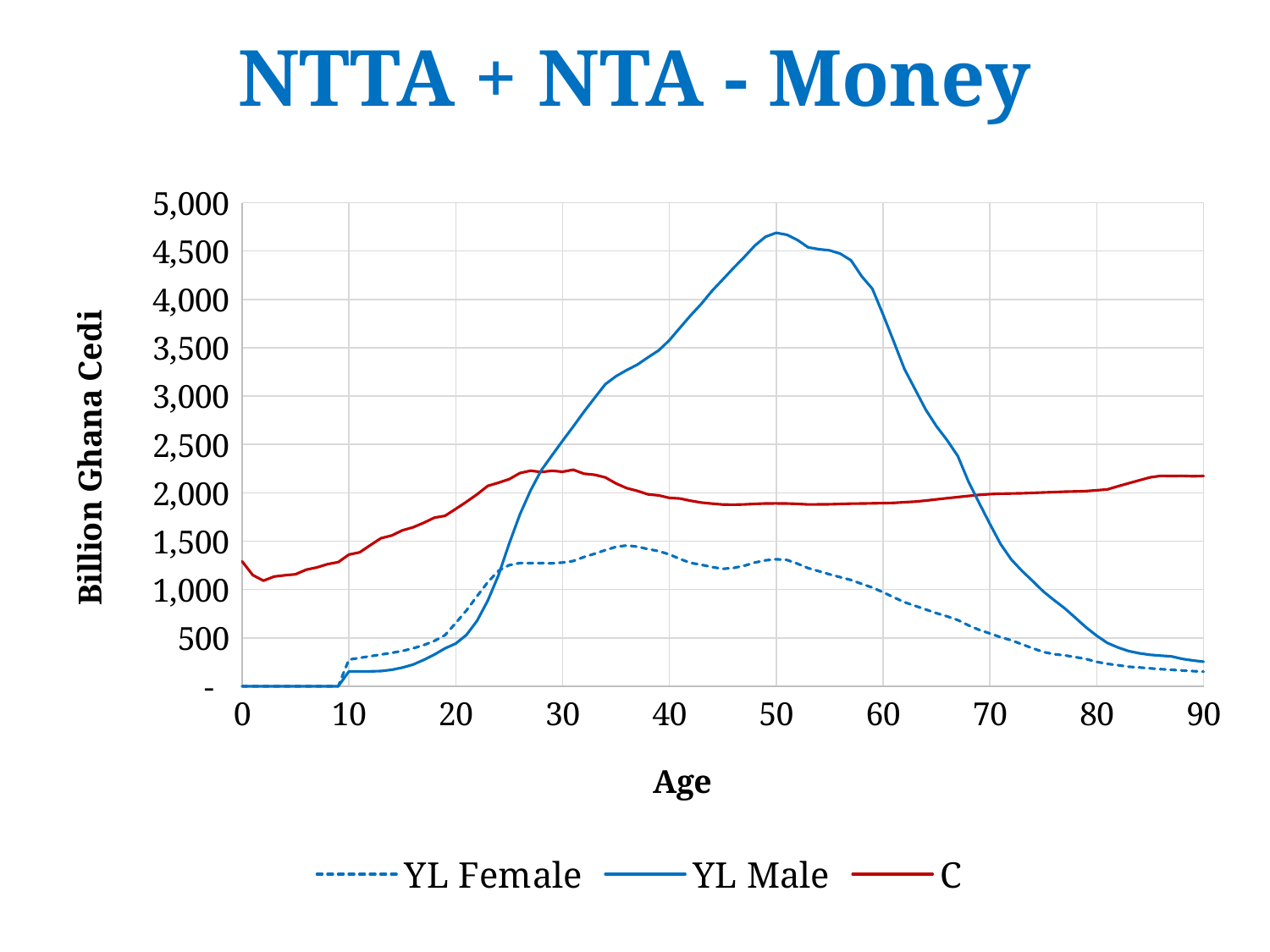
How many series does the legend list? 3 At age 50, which series has the larger value, YL Male or C? YL Male Is the value for YL Male at age 0 greater or less than 500? less Is the value for YL Female at age 50 greater or less than 1,500? less Is the value for YL Male at age 50 greater or less than 4,500? greater Which series reaches the highest value on the chart? YL Male What is the title of the chart? NTTA + NTA - Money What is the label on the vertical axis? Billion Ghana Cedi Does the YL Male series rise or fall between age 50 and age 90? fall At age 80, which series has the larger value, C or YL Male? C What kind of chart is shown on the slide? line chart